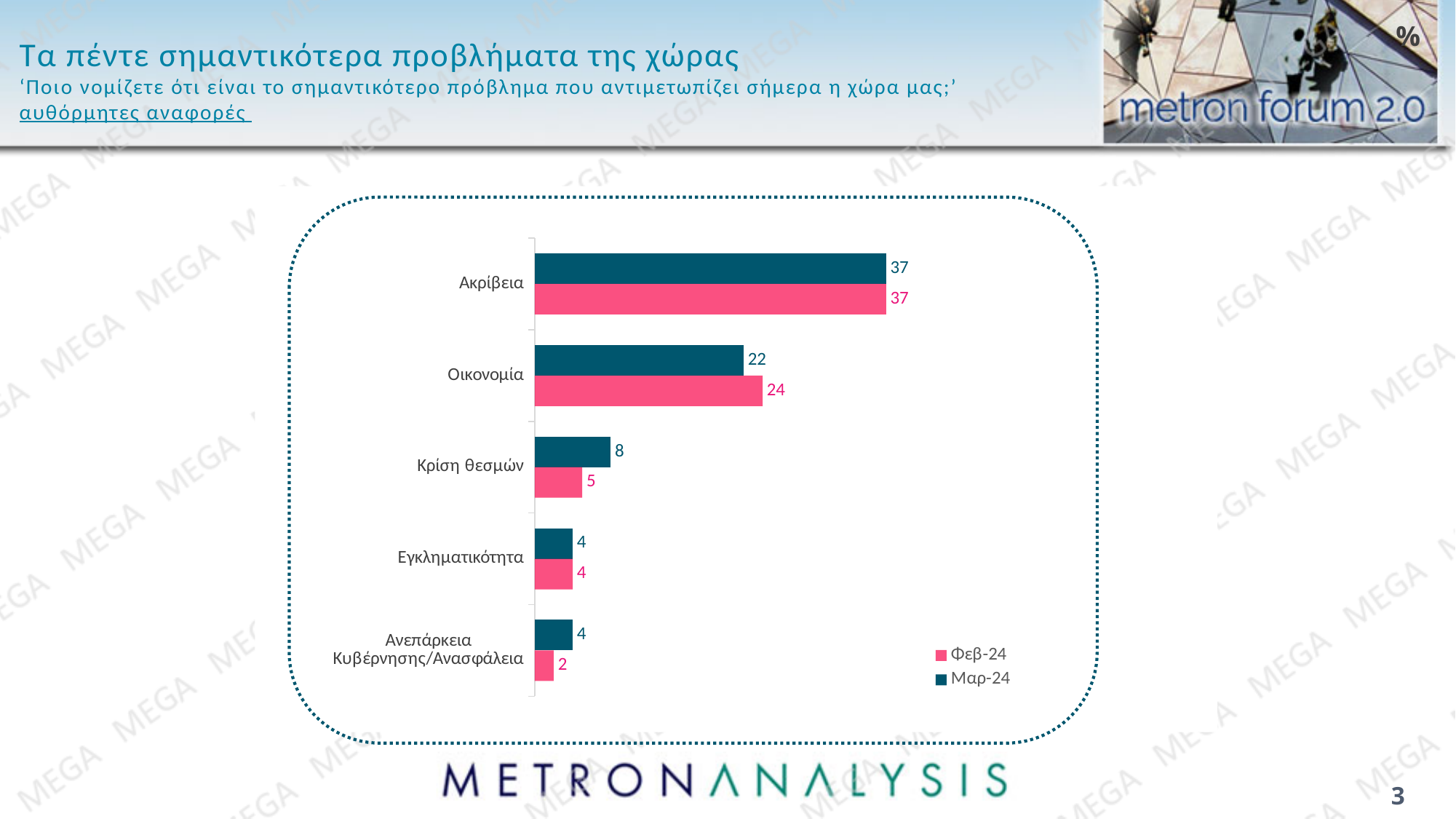
What kind of chart is shown on the slide? Bar chart What is the value for Κρίση θεσμών in the Μαρ-24 series? 8 What is the value for Ανεπάρκεια Κυβέρνησης/Ανασφάλεια in the Φεβ-24 series? 2 What is the value for Οικονομία in the Φεβ-24 series? 24 Which category has the highest value in the Μαρ-24 series? Ακρίβεια What is the value for Ακρίβεια in the Μαρ-24 series? 37 Which colour represents the Φεβ-24 series in the chart? Pink For Κρίση θεσμών, which series has the larger value, Φεβ-24 or Μαρ-24? Μαρ-24 How many series does the legend list? 2 How many categories are shown in the chart? 5 What is the difference between the Φεβ-24 and Μαρ-24 values for Οικονομία? 2 Which category has the lowest value in the Φεβ-24 series? Ανεπάρκεια Κυβέρνησης/Ανασφάλεια